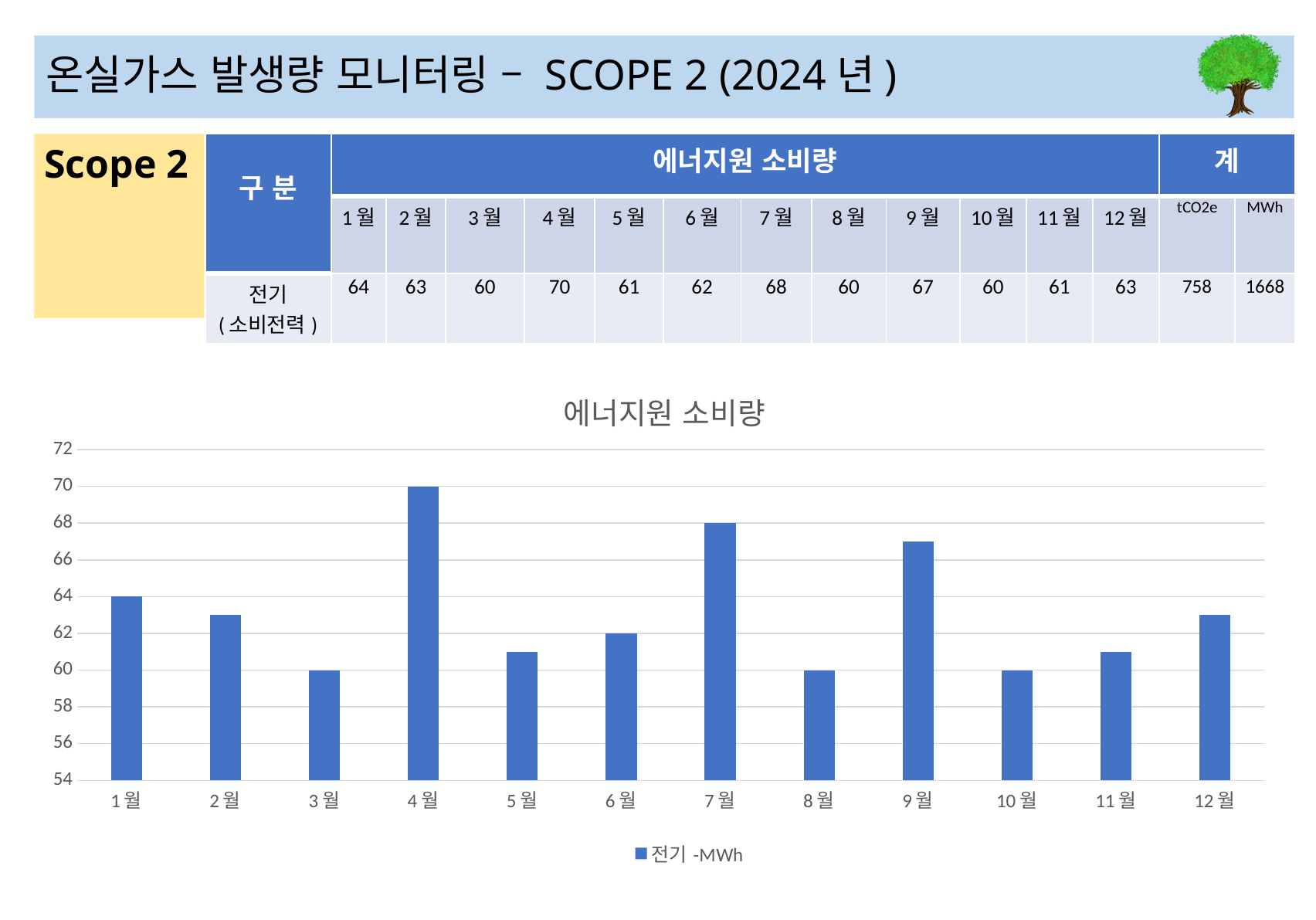
Is the value for 5월 greater or less than 62? less What is the title of the chart? 에너지원 소비량 How many series does the chart legend list? 1 Is the value for 9월 greater or less than 66? greater What is the value for 7월 in the chart? 68 What is the value for 4월 in the chart? 70 Which month has the highest value in the chart? 4월 Which is larger, the value for 7월 or the value for 8월? 7월 What is the difference between the values for 4월 and 3월? 10 What kind of chart is shown on the slide? bar chart What is the value for 1월 in the chart? 64 How many months are plotted on the x axis of the chart? 12